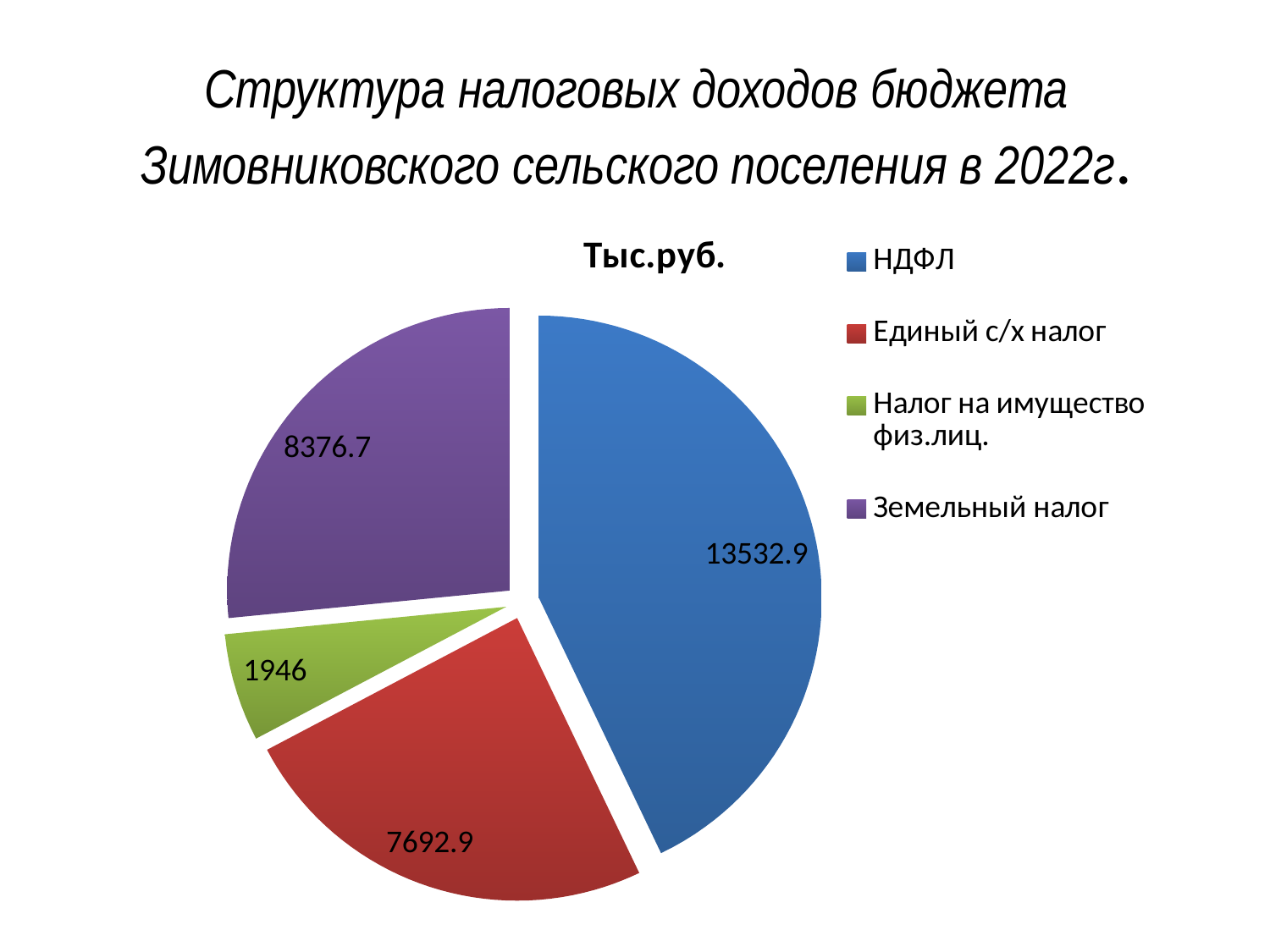
Which is larger, the value for Единый с/х налог or the value for Земельный налог? Земельный налог What is the value for НДФЛ? 13532.9 Which category has the largest slice? НДФЛ Which category has the smallest slice? Налог на имущество физ.лиц. What is the value for Единый с/х налог? 7692.9 How many categories does the pie chart show? 4 What is the difference between the values for Земельный налог and Единый с/х налог? 683.8 What is the value for Налог на имущество физ.лиц.? 1946 What kind of chart is shown on the slide? Pie chart What is the value for Земельный налог? 8376.7 What is the difference between the values for НДФЛ and Земельный налог? 5156.2 What is the title shown above the pie chart? Тыс.руб.